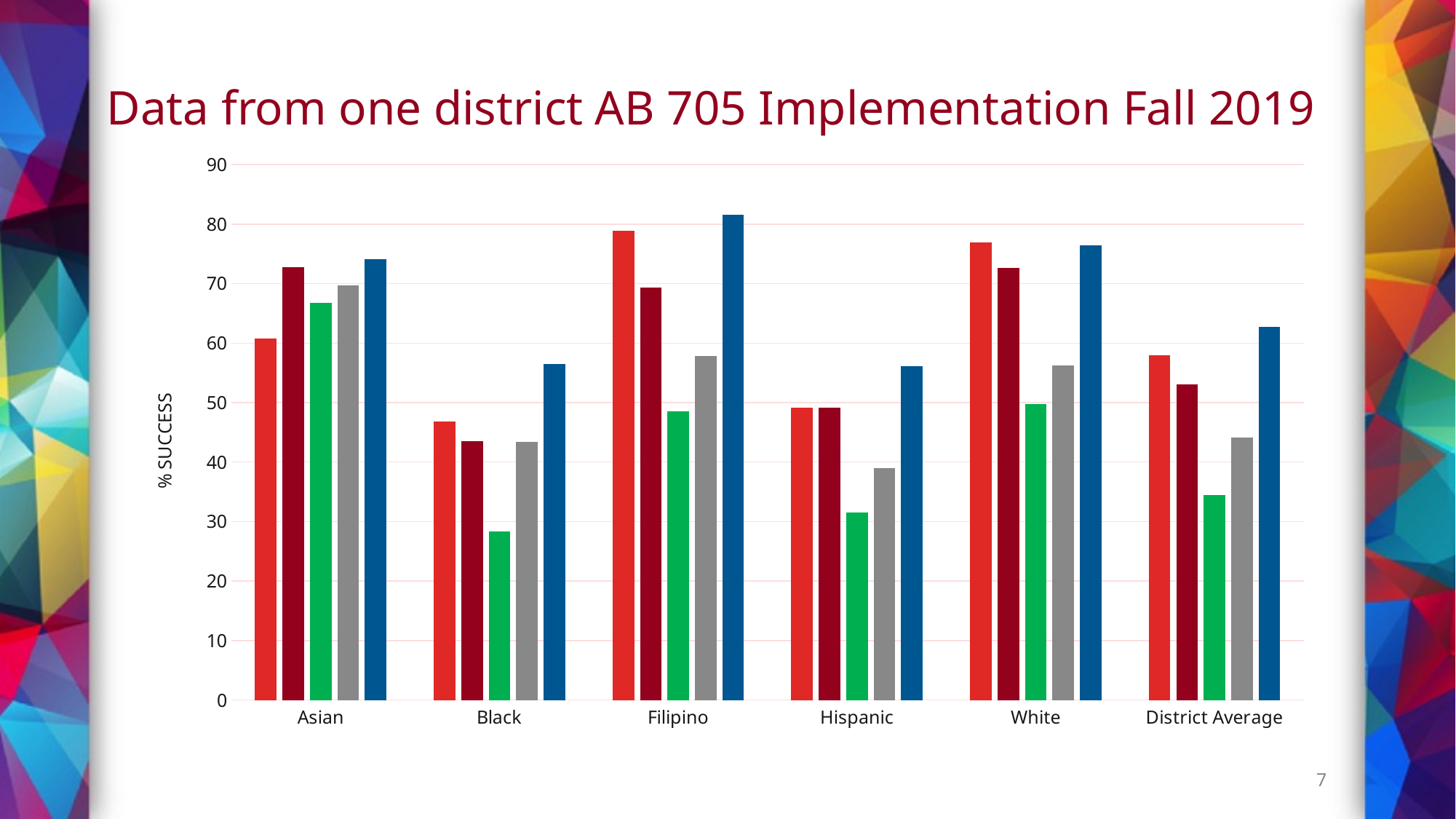
Which is larger, the blue bar for Filipino or the blue bar for White? Filipino What is the label on the vertical axis? % SUCCESS What kind of chart is shown on the slide? bar chart Is the value of the blue bar for Filipino greater or less than 80? greater Which category contains the shortest bar in the chart? Black How many categories are shown on the x axis? 6 Is the value of the blue bar for District Average greater or less than 60? greater Is the value of the green bar for District Average greater or less than 40? less What is the title of the chart? Data from one district AB 705 Implementation Fall 2019 Which category contains the tallest bar in the chart? Filipino How many bars are plotted for each category? 5